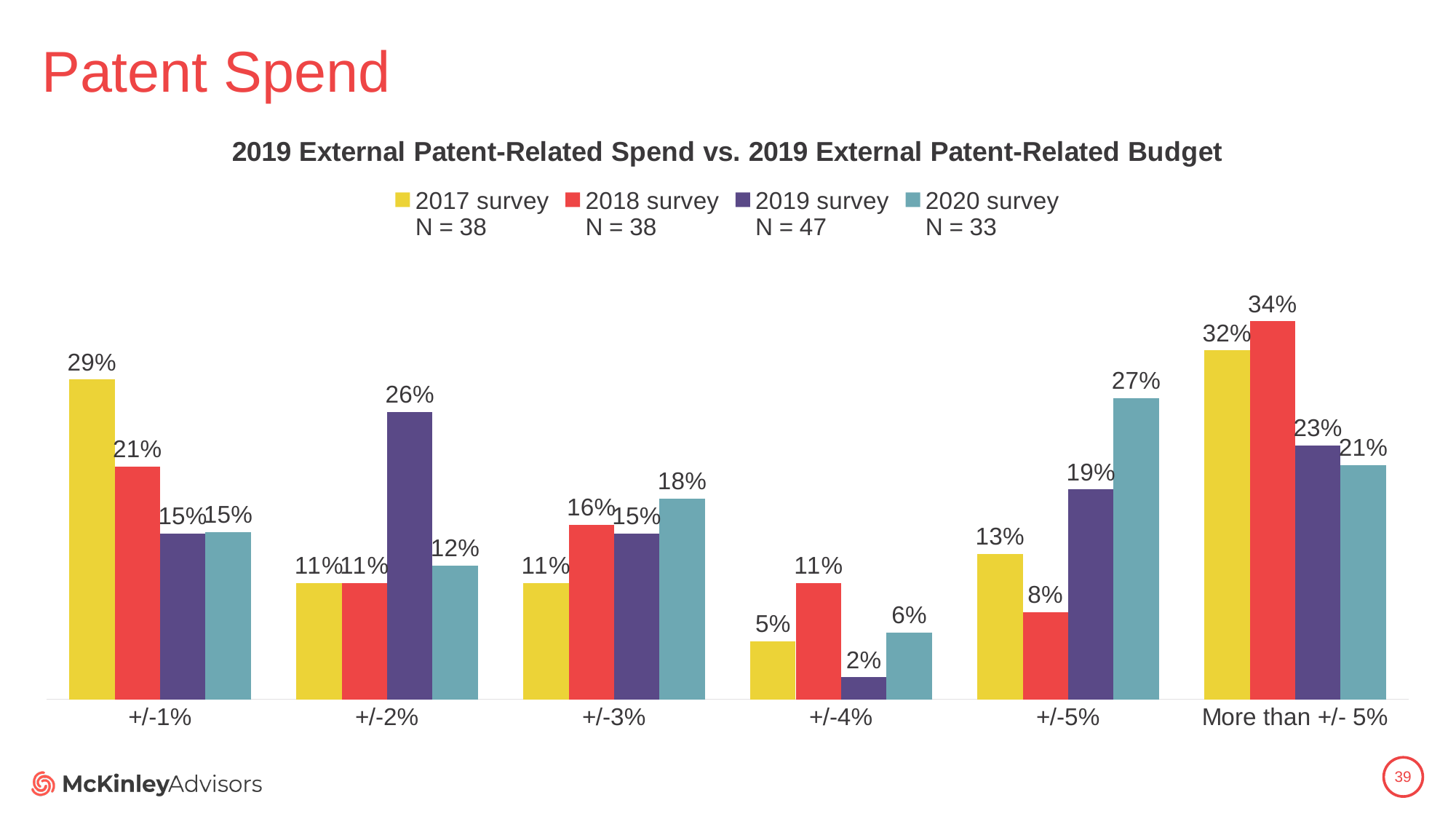
Which is larger in the +/-2% category: the 2019 survey value or the 2020 survey value? 2019 survey What is the title of the chart? 2019 External Patent-Related Spend vs. 2019 External Patent-Related Budget Which category has the highest value for the 2018 survey? More than +/- 5% How many categories are shown on the x axis? 6 How many series does the legend list? 4 Which category has the lowest value for the 2020 survey? +/-4% What is the value for the 2019 survey in the +/-4% category? 2% What kind of chart is shown on the slide? Bar chart What is the sample size (N) for the 2019 survey shown in the legend? N = 47 What is the value for the 2017 survey in the +/-1% category? 29% What is the value for the 2020 survey in the +/-5% category? 27% What is the difference between the 2018 survey and 2017 survey values in the More than +/- 5% category? 2%